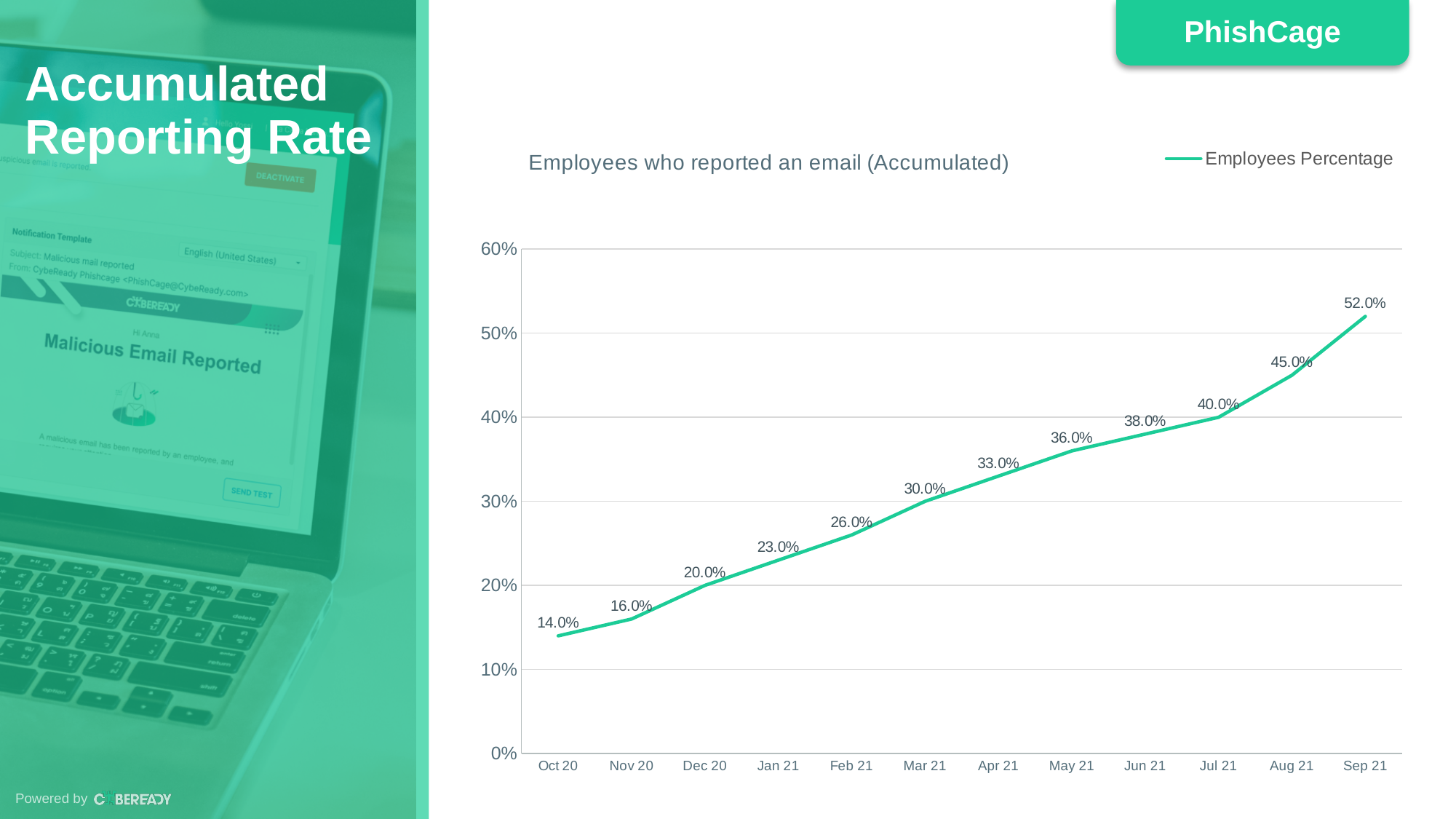
Which month has the highest value? Sep 21 How many months are plotted on the x axis? 12 How many series does the legend list? 1 What is the title of the chart? Employees who reported an email (Accumulated) What is the difference between the values for Sep 21 and Oct 20? 38.0% What kind of chart is shown? Line chart What is the value for Mar 21? 30.0% Which is larger, the value for Jun 21 or the value for Apr 21? Jun 21 Which month has the lowest value? Oct 20 Do the values rise or fall from Oct 20 to Sep 21? Rise What is the value for Oct 20? 14.0% What is the value for Sep 21? 52.0%